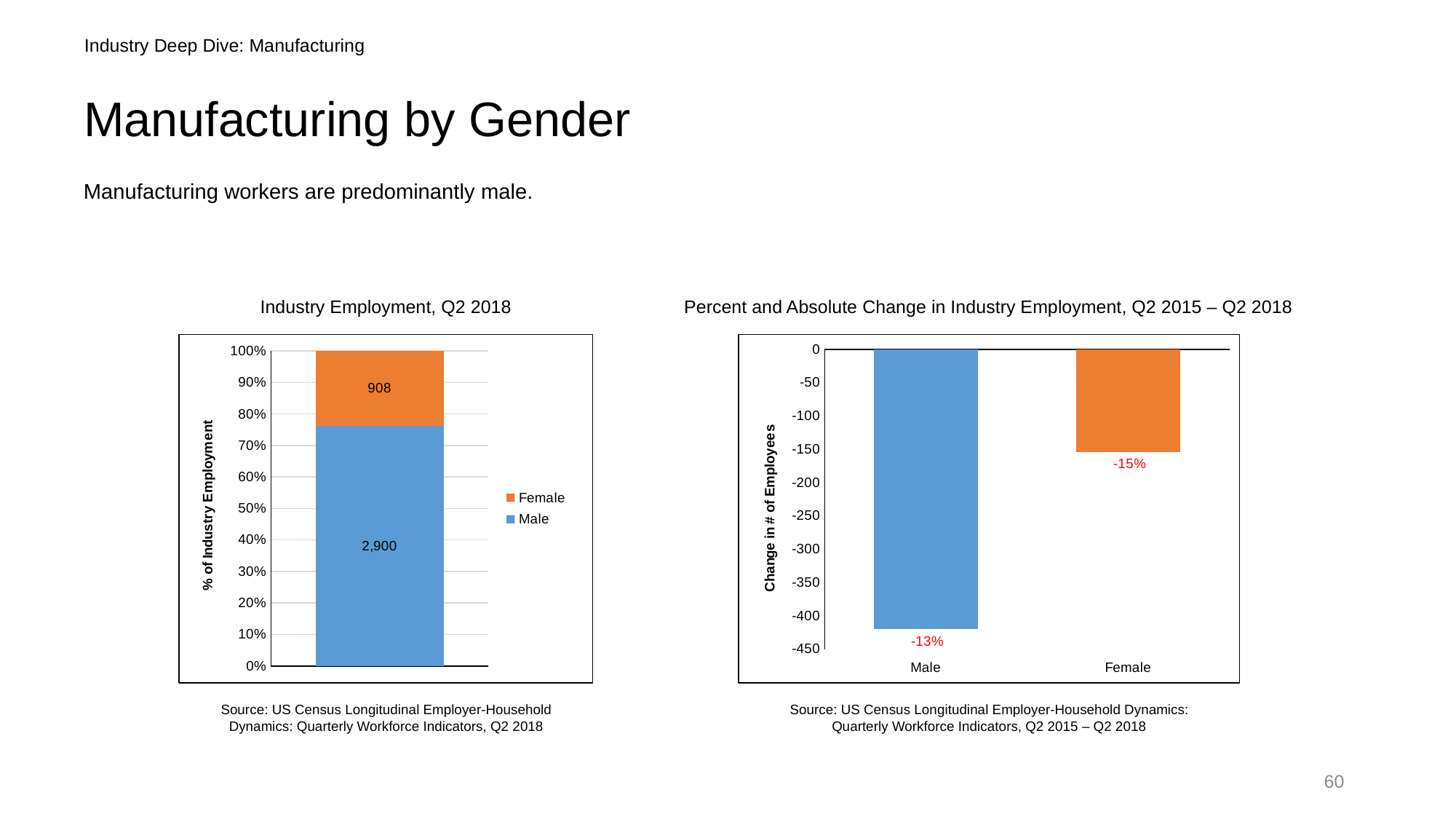
In the 'Industry Employment, Q2 2018' chart, what is the difference between the Male and Female values? 1,992 In the 'Percent and Absolute Change in Industry Employment, Q2 2015 – Q2 2018' chart, what percent change is labeled for Female? -15% In the 'Industry Employment, Q2 2018' chart, which is larger, the Male value or the Female value? Male In the 'Percent and Absolute Change in Industry Employment, Q2 2015 – Q2 2018' chart, what is the title of the vertical axis? Change in # of Employees In the 'Industry Employment, Q2 2018' chart, what is the value shown for Female? 908 In the 'Industry Employment, Q2 2018' chart, what is the value shown for Male? 2,900 What kind of chart is the 'Industry Employment, Q2 2018' chart? Stacked bar chart In the 'Percent and Absolute Change in Industry Employment, Q2 2015 – Q2 2018' chart, is the change in number of employees for Male greater or less than -400? less In the 'Industry Employment, Q2 2018' chart, how many series does the legend list? 2 In the 'Percent and Absolute Change in Industry Employment, Q2 2015 – Q2 2018' chart, is the change in number of employees for Female greater or less than -200? greater In the 'Industry Employment, Q2 2018' chart, what is the total of the stacked bar (Male plus Female)? 3,808 In the 'Percent and Absolute Change in Industry Employment, Q2 2015 – Q2 2018' chart, what percent change is labeled for Male? -13%